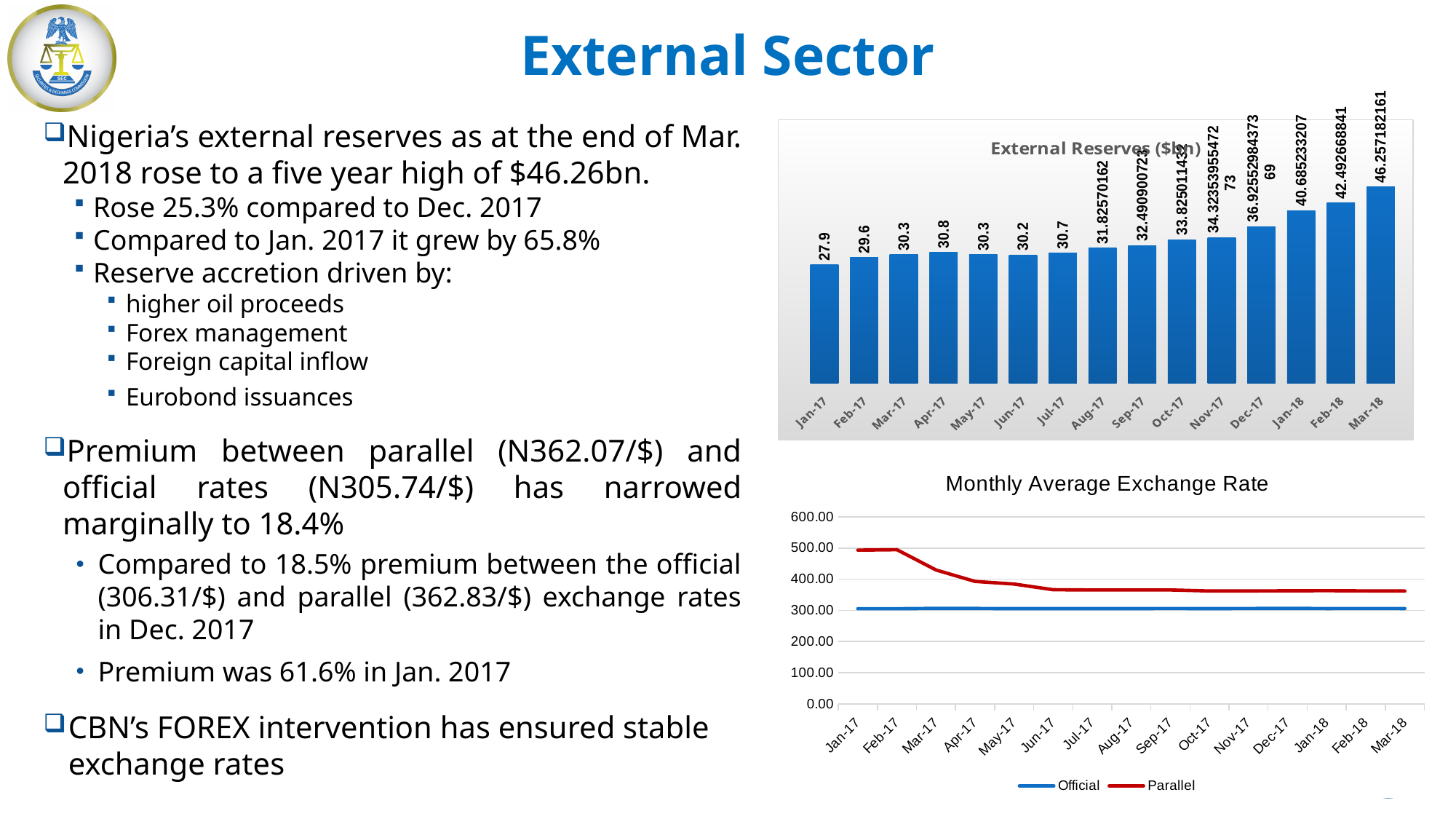
In the External Reserves ($bn) chart, which month has the highest value? Mar-18 In the External Reserves ($bn) chart, what is the difference between the Feb-17 and Jan-17 values? 1.7 How many series does the legend of the Monthly Average Exchange Rate chart list? 2 In the External Reserves ($bn) chart, which is larger, the value for Jan-18 or Feb-18? Feb-18 In the Monthly Average Exchange Rate chart, is the Official value for Mar-18 greater or less than 400.00? less In the External Reserves ($bn) chart, which month has the lowest value? Jan-17 What kind of chart is the External Reserves ($bn) chart? Bar chart How many months are shown in the External Reserves ($bn) chart? 15 In the External Reserves ($bn) chart, do the values generally rise or fall from Jan-17 to Mar-18? Rise In the External Reserves ($bn) chart, what is the value for Mar-18? 46.257182161 In the External Reserves ($bn) chart, what is the value for Jan-17? 27.9 In the Monthly Average Exchange Rate chart, is the Parallel value for Jan-17 greater or less than 400.00? greater